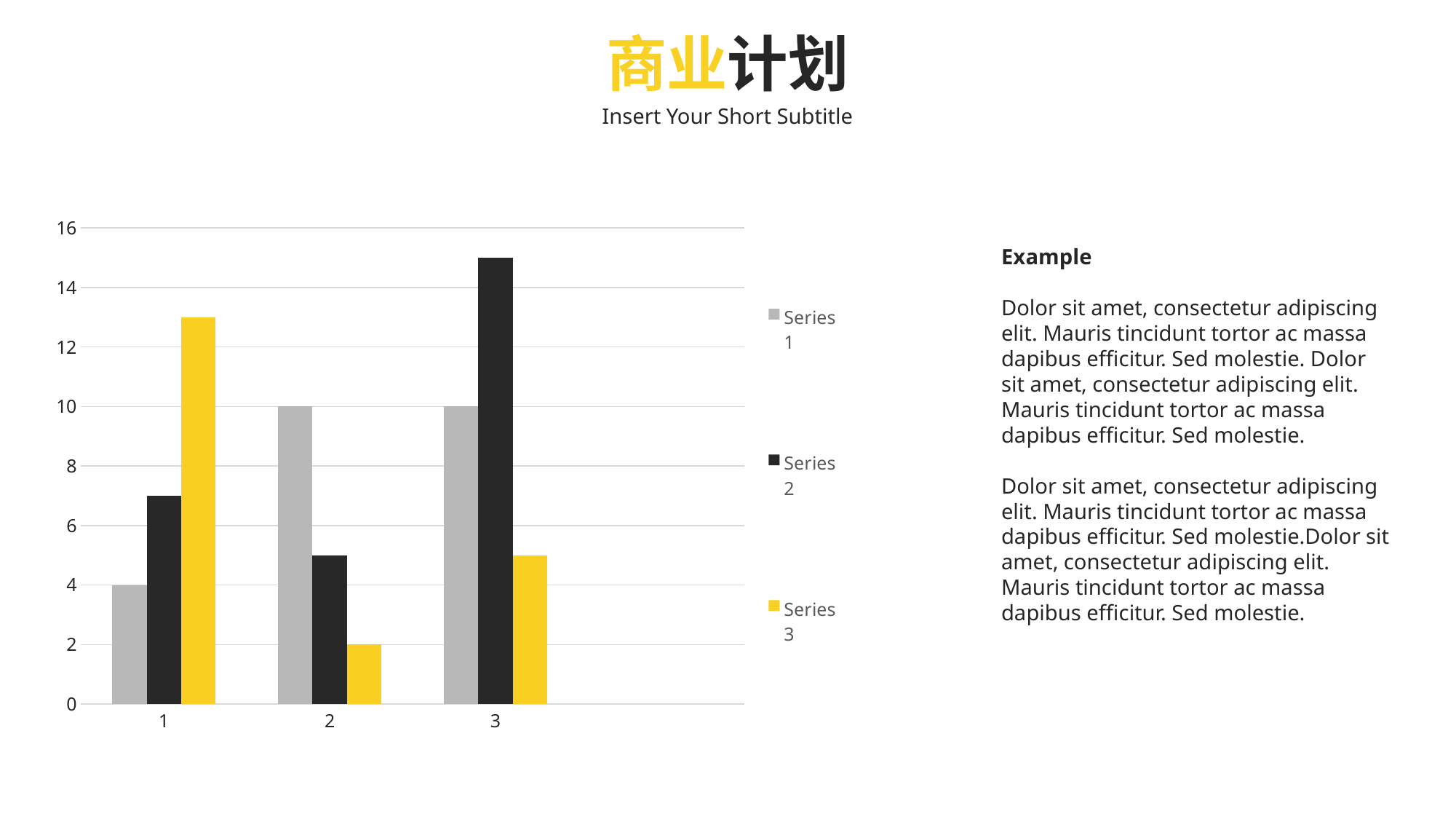
How many series does the chart legend list? 3 Is the value of Series 2 for category 2 greater or less than 6? less What kind of chart is shown on the slide? bar chart What is the value of Series 1 for category 1? 4 What is the value of Series 3 for category 2? 2 How many categories are shown on the x axis of the chart? 3 Which is larger for category 1: Series 1 or Series 3? Series 3 Is the value of Series 3 for category 1 greater or less than 12? greater Which category has the highest value for Series 2? 3 What is the value of Series 1 for category 2? 10 Which category has the lowest value for Series 3? 2 Is the value of Series 2 for category 3 greater or less than 14? greater